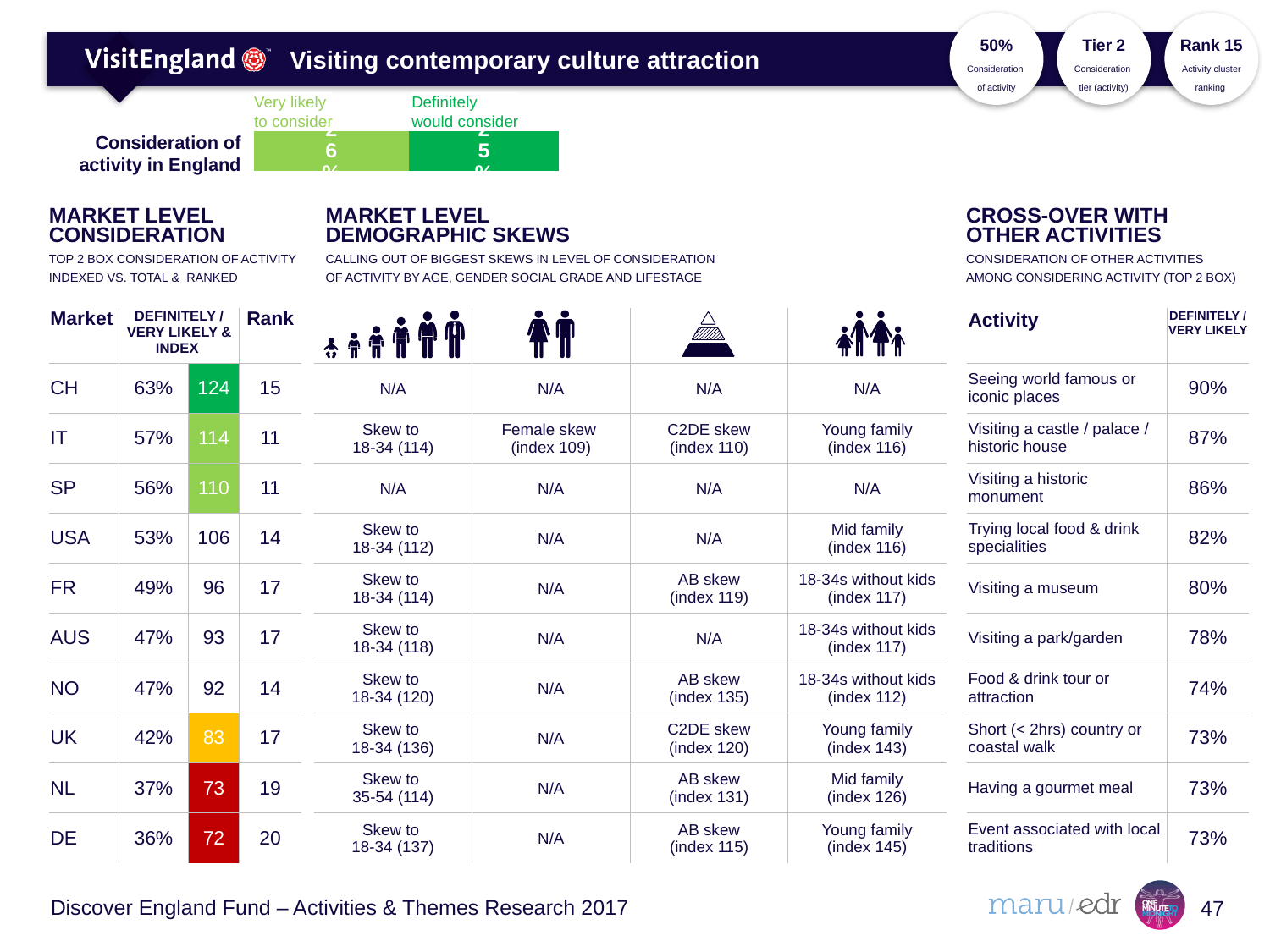
How many series does the legend of the 'Consideration of activity in England' chart list? 2 How many categories are plotted in the 'Consideration of activity in England' chart? 1 In the 'Consideration of activity in England' chart, what is the value for 'Definitely would consider'? 25% What kind of chart is the 'Consideration of activity in England' chart? Stacked bar chart What is the category label of the bar in the stacked bar chart at the top of the slide? Consideration of activity in England In the 'Consideration of activity in England' chart, which legend entry is shown in the lighter green colour? Very likely to consider In the 'Consideration of activity in England' chart, which segment is larger: 'Very likely to consider' or 'Definitely would consider'? Very likely to consider In the 'Consideration of activity in England' chart, what is the value for 'Very likely to consider'? 26% In the 'Consideration of activity in England' chart, what is the difference between the 'Very likely to consider' and 'Definitely would consider' values? 1%